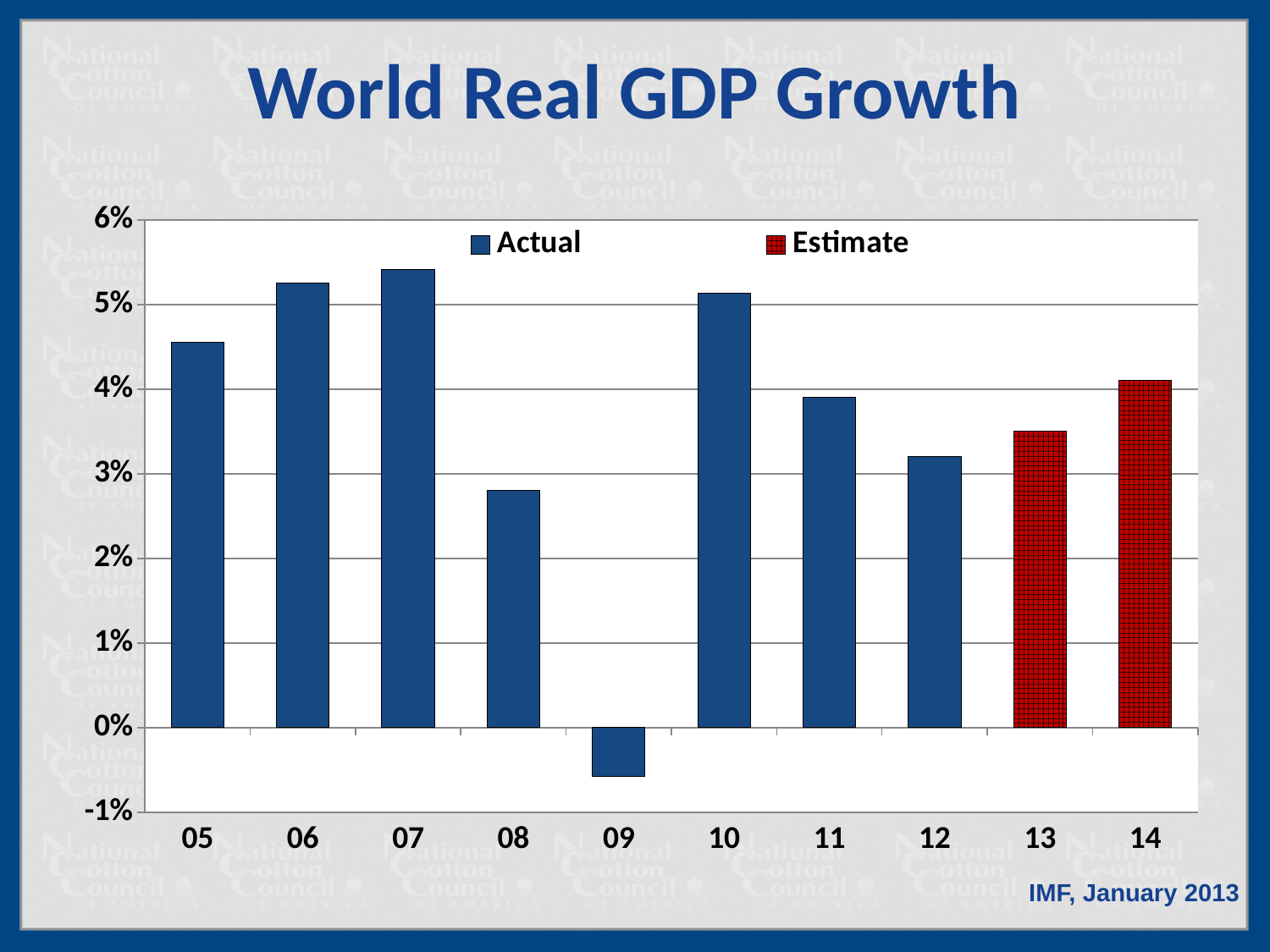
Which is larger, the value for 05 or the value for 08? 05 What kind of chart is shown on the slide? bar chart How many years are plotted on the x axis? 10 How many series does the legend list? 2 Which years are shown as estimates rather than actual values? 13 and 14 Is the value for 05 greater or less than 4%? greater Is the value for 13 greater or less than 3%? greater Is the value for 09 greater or less than 0%? less Do the values rise or fall from 10 to 12? fall Which is larger, the value for 13 or the value for 14? 14 Which year has the lowest world real GDP growth? 09